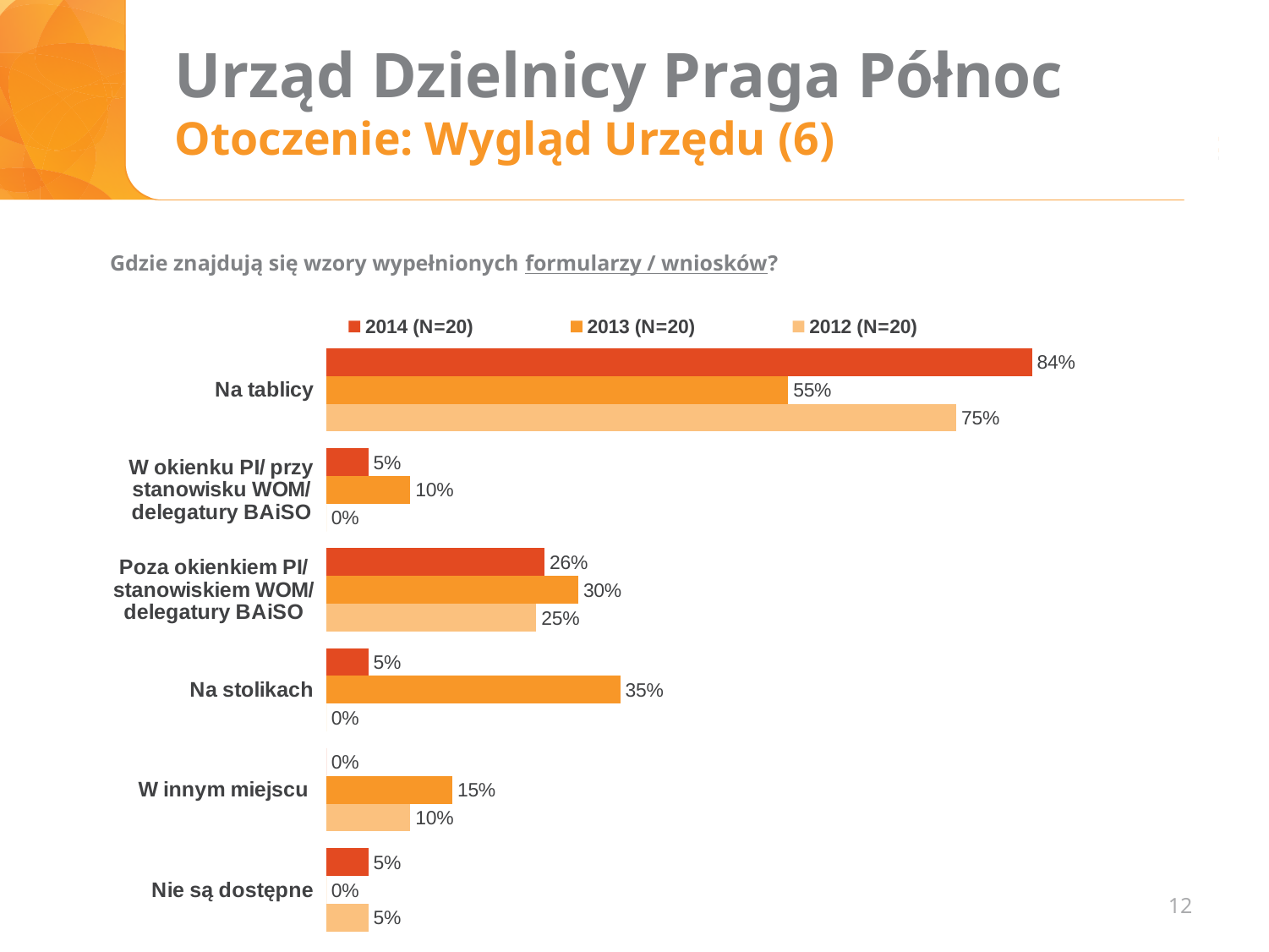
Which category has the highest value in the 2013 (N=20) series? Na tablicy Which is larger for 'Poza okienkiem PI/ stanowiskiem WOM/ delegatury BAiSO': the 2013 (N=20) value or the 2012 (N=20) value? 2013 (N=20) Which category has the lowest value in the 2014 (N=20) series? W innym miejscu What is the value for 'Na tablicy' in the 2014 (N=20) series? 84% How many categories are shown on the chart? 6 What is the value for 'W innym miejscu' in the 2012 (N=20) series? 10% What is the difference between the 2014 (N=20) and 2013 (N=20) values for 'Na tablicy'? 29% What kind of chart is shown on the slide? Bar chart What is the value for 'Na stolikach' in the 2013 (N=20) series? 35% How many series does the legend list? 3 What question is the chart answering, as written above it? Gdzie znajdują się wzory wypełnionych formularzy / wniosków? What is the value for 'Nie są dostępne' in the 2013 (N=20) series? 0%